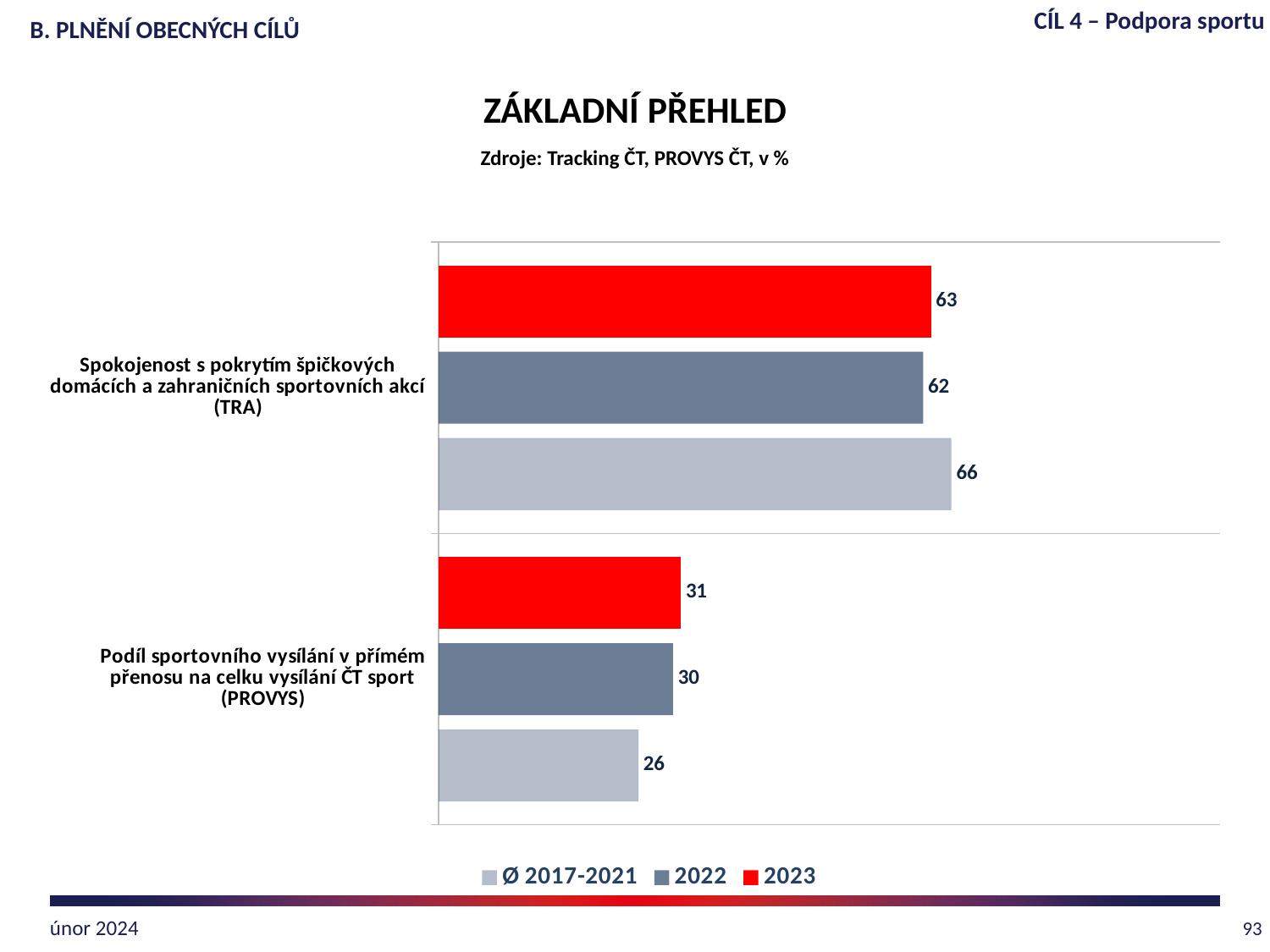
What is the 2023 value for 'Spokojenost s pokrytím špičkových domácích a zahraničních sportovních akcí (TRA)'? 63 What is the difference between the Ø 2017-2021 and 2022 values for 'Spokojenost s pokrytím špičkových domácích a zahraničních sportovních akcí (TRA)'? 4 What is the Ø 2017-2021 value for 'Spokojenost s pokrytím špičkových domácích a zahraničních sportovních akcí (TRA)'? 66 What is the difference between the 2023 and Ø 2017-2021 values for 'Podíl sportovního vysílání v přímém přenosu na celku vysílání ČT sport (PROVYS)'? 5 What is the 2022 value for 'Podíl sportovního vysílání v přímém přenosu na celku vysílání ČT sport (PROVYS)'? 30 Which is larger for 'Podíl sportovního vysílání v přímém přenosu na celku vysílání ČT sport (PROVYS)': the 2023 value or the Ø 2017-2021 value? 2023 What kind of chart is shown on the slide? Bar chart How many categories are shown on the chart? 2 What is the Ø 2017-2021 value for 'Podíl sportovního vysílání v přímém přenosu na celku vysílání ČT sport (PROVYS)'? 26 Which series has the highest value for 'Spokojenost s pokrytím špičkových domácích a zahraničních sportovních akcí (TRA)'? Ø 2017-2021 How many series does the legend list? 3 Which series has the lowest value for 'Podíl sportovního vysílání v přímém přenosu na celku vysílání ČT sport (PROVYS)'? Ø 2017-2021